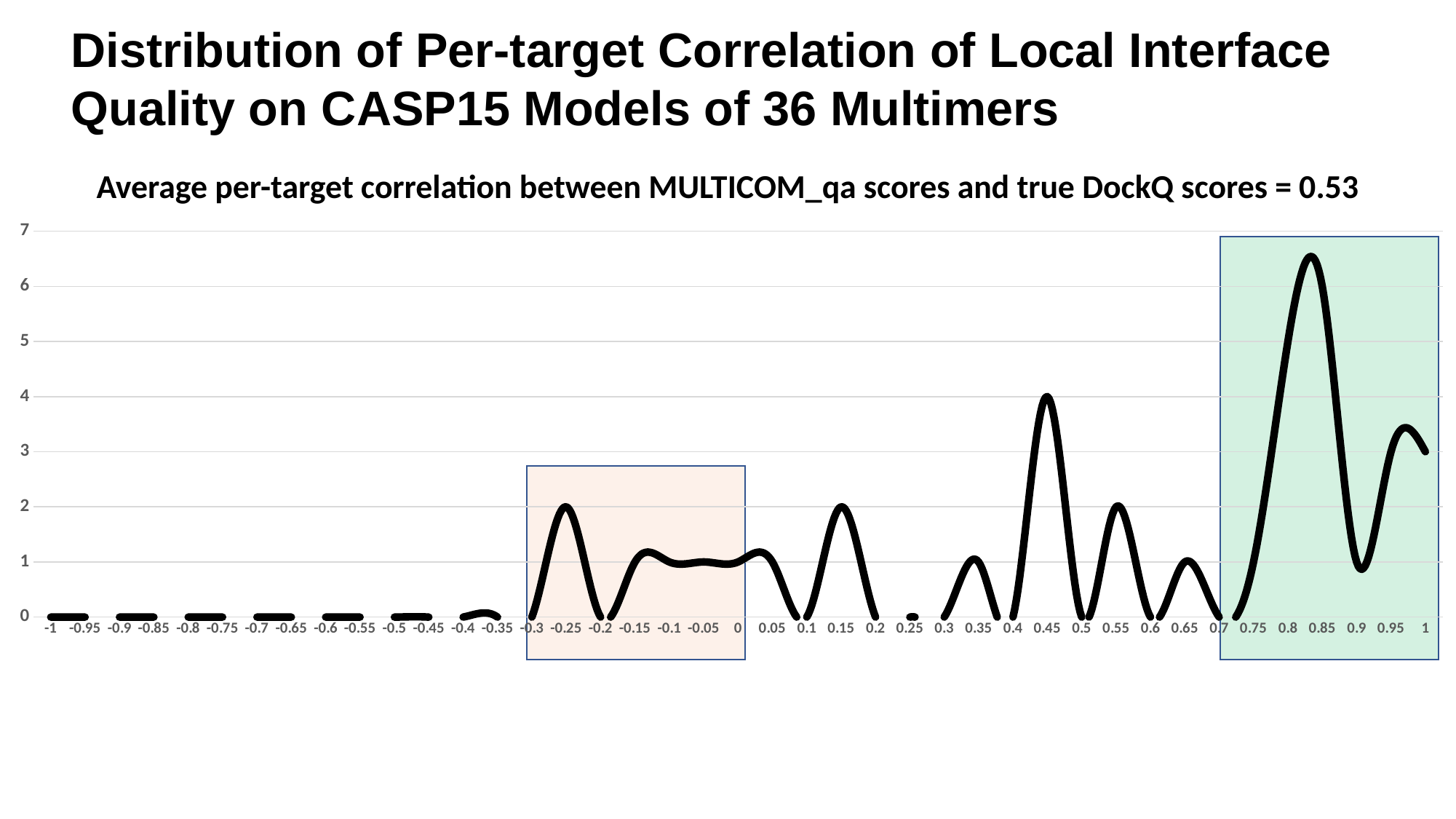
At which x-axis value does the line reach its highest point? 0.85 Which is larger, the value at x = 0.45 or the value at x = 0.55? 0.45 What kind of chart is shown on the slide? line chart How many multimers does the chart title say the CASP15 models cover? 36 What is the value of the line at x = 0.15? 2 What is the value of the line at x = 0.45? 4 What is the value of the line at x = -0.5? 0 Is the value of the line at x = 0.35 greater or less than 2? less What is the average per-target correlation stated in the chart's subtitle? 0.53 What is the value of the line at x = 1? 3